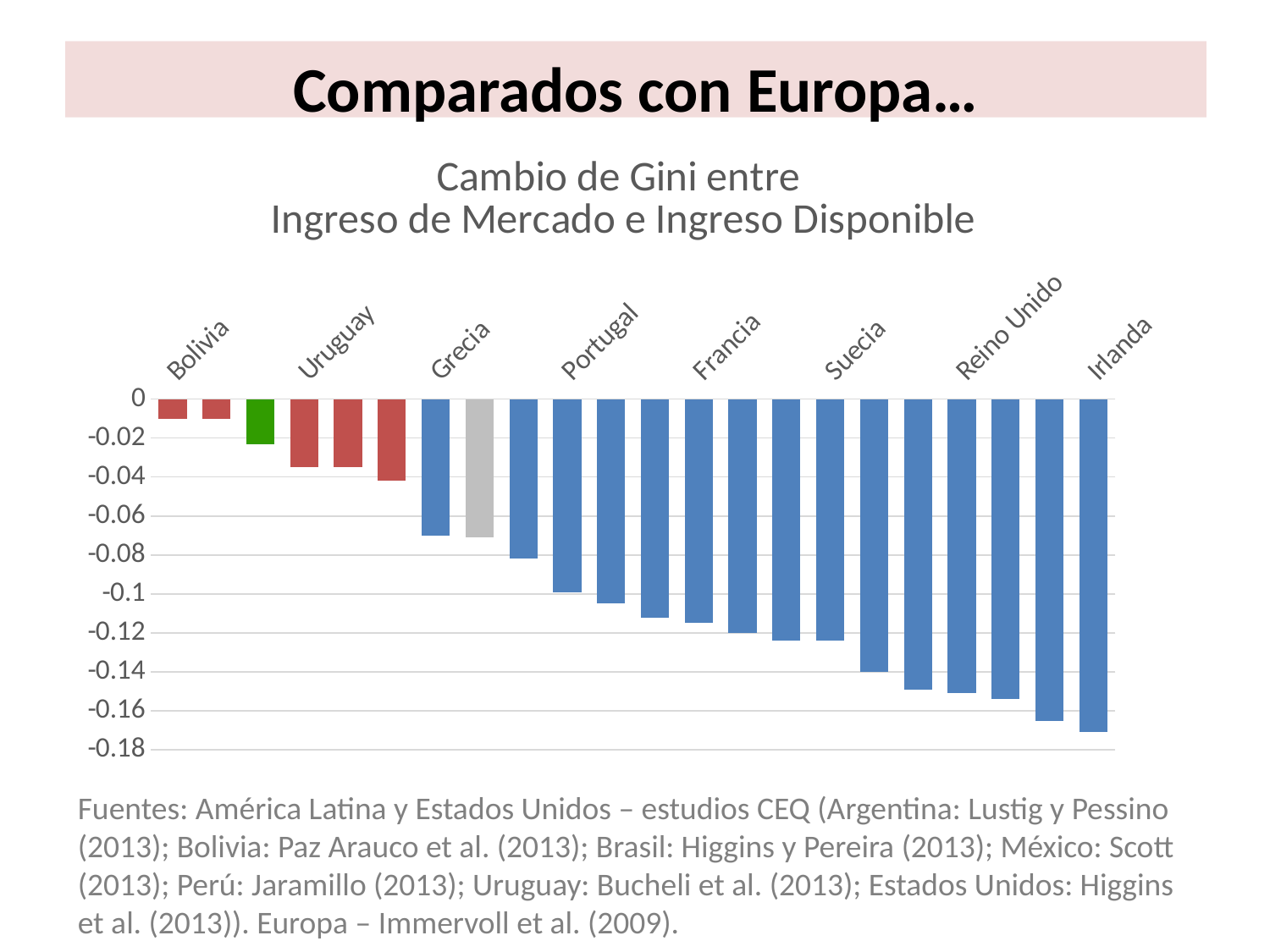
How many bars are plotted in the chart? 22 Is the value for Francia greater or less than -0.1? less Is the value for Reino Unido greater or less than -0.14? less Is the value for Grecia greater or less than -0.08? greater What is the title of the chart? Cambio de Gini entre Ingreso de Mercado e Ingreso Disponible What kind of chart is shown on the slide? bar chart Do the values generally rise or fall moving from left to right along the x axis? fall Which labeled country has the lowest (most negative) value in the chart? Irlanda What colour is the bar for Uruguay? red Which has the higher (less negative) value, Grecia or Francia? Grecia